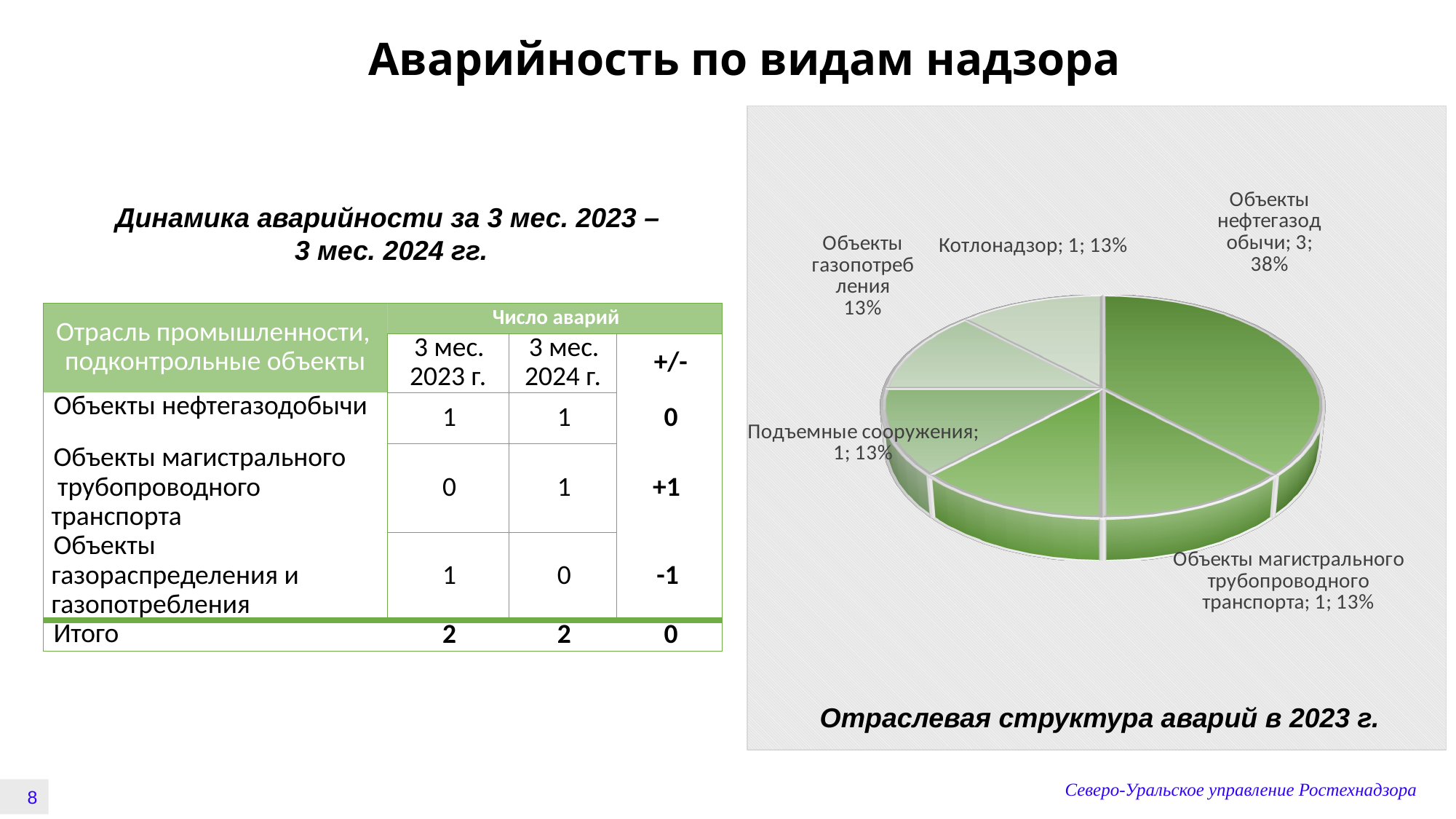
What kind of chart is shown on the right side of the slide? pie chart In the pie chart, what share of accidents is attributed to Подъемные сооружения? 13% In the pie chart, what is the difference in the number of accidents between Объекты нефтегазодобычи and Подъемные сооружения? 2 In the pie chart, what share of accidents is attributed to Объекты магистрального трубопроводного транспорта? 13% In the pie chart, how many accidents are shown for Объекты нефтегазодобычи? 3 What colour are the slices of the pie chart? green In the pie chart, what share of accidents is attributed to Объекты газопотребления? 13% What is the title of the pie chart? Отраслевая структура аварий в 2023 г. Which category has the largest slice in the pie chart? Объекты нефтегазодобычи In the pie chart, which has the larger share: Объекты нефтегазодобычи or Котлонадзор? Объекты нефтегазодобычи In the pie chart, how many accidents are shown for Котлонадзор? 1